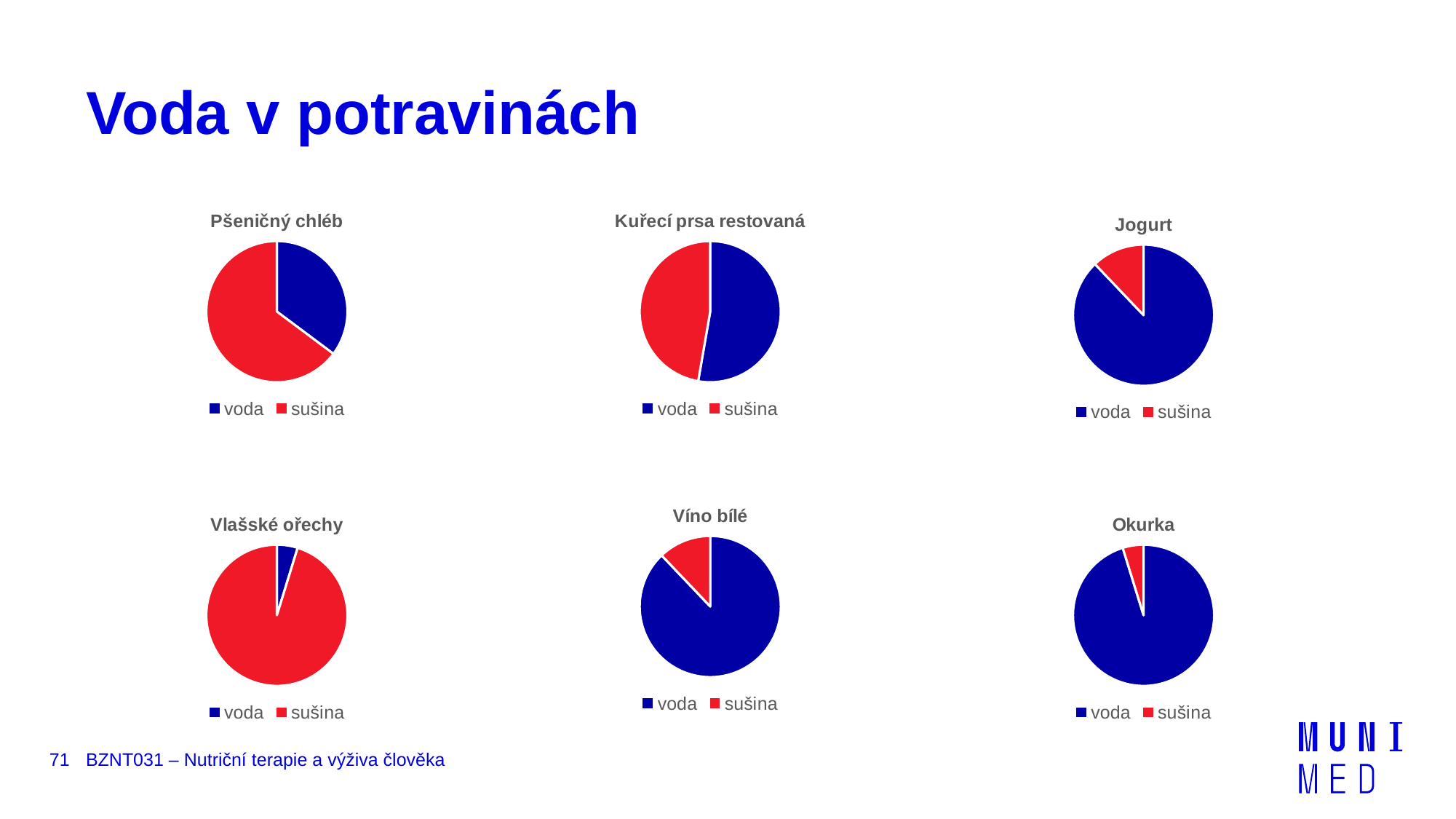
What colour represents voda in the pie charts? blue How many pie charts are shown on the slide? 6 How many entries does the legend of the Okurka chart list? 2 What are the two legend entries in the Kuřecí prsa restovaná chart? voda, sušina In the Vlašské ořechy chart, which slice is larger, voda or sušina? sušina Across the six pie charts, which food has the smallest voda share? Vlašské ořechy In the Víno bílé chart, which slice is larger, voda or sušina? voda In the Pšeničný chléb chart, which slice is larger, voda or sušina? sušina What kind of chart is the Pšeničný chléb chart? pie chart How many slices does the Jogurt pie chart have? 2